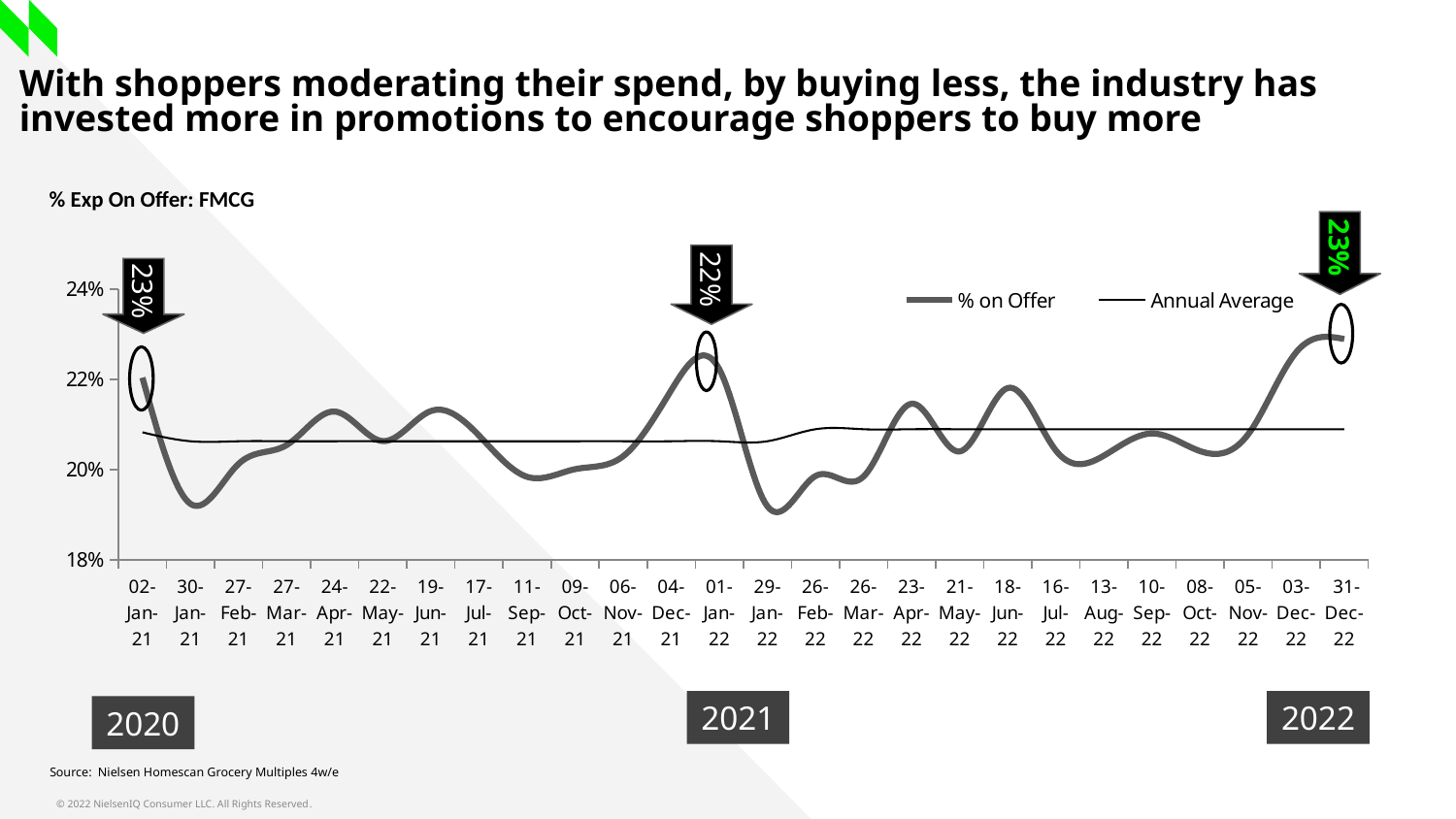
Is the % on Offer value for 29-Jan-22 greater or less than 20%? less What % on Offer value is called out for 02-Jan-21? 23% Which is larger, the called-out % on Offer value for 02-Jan-21 or for 01-Jan-22? 02-Jan-21 How many series does the chart legend list? 2 Is the Annual Average line for 2021 greater or less than 22%? less What % on Offer value is called out for 31-Dec-22? 23% What is the difference between the called-out % on Offer values for 02-Jan-21 and 01-Jan-22? 1% What % on Offer value is called out for 01-Jan-22? 22% What is the title of the chart? % Exp On Offer: FMCG What are the two series named in the chart legend? % on Offer and Annual Average What kind of chart is shown on the slide? line chart Is the % on Offer value for 30-Jan-21 greater or less than 20%? less